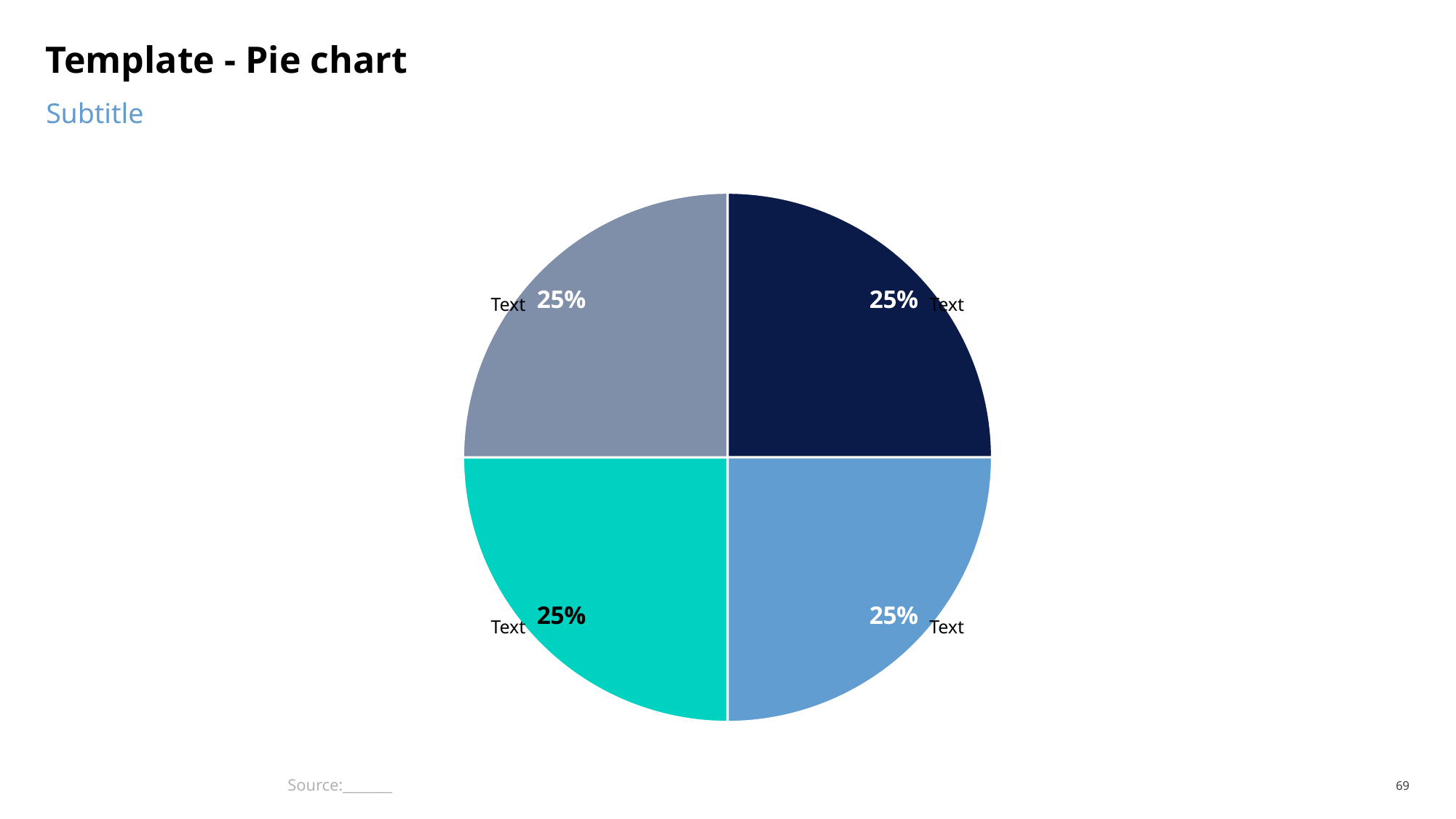
What share of the pie does the teal slice represent? 25% What percentage is shown on the dark navy slice in the top right of the pie chart? 25% Do all four slices of the pie chart show the same value? yes How many slices does the pie chart have? 4 What percentage is shown on the light blue slice in the bottom right of the pie chart? 25% What kind of chart is shown on the slide? pie chart What is the title of the slide containing the pie chart? Template - Pie chart What percentage is shown on the grey slice in the top left of the pie chart? 25% What label text is shown next to each slice of the pie chart? Text What is the total of the four slice values printed on the pie chart? 100% What percentage is shown on the teal slice in the bottom left of the pie chart? 25% What is the difference between the value of the dark navy slice and the value of the light blue slice? 0%